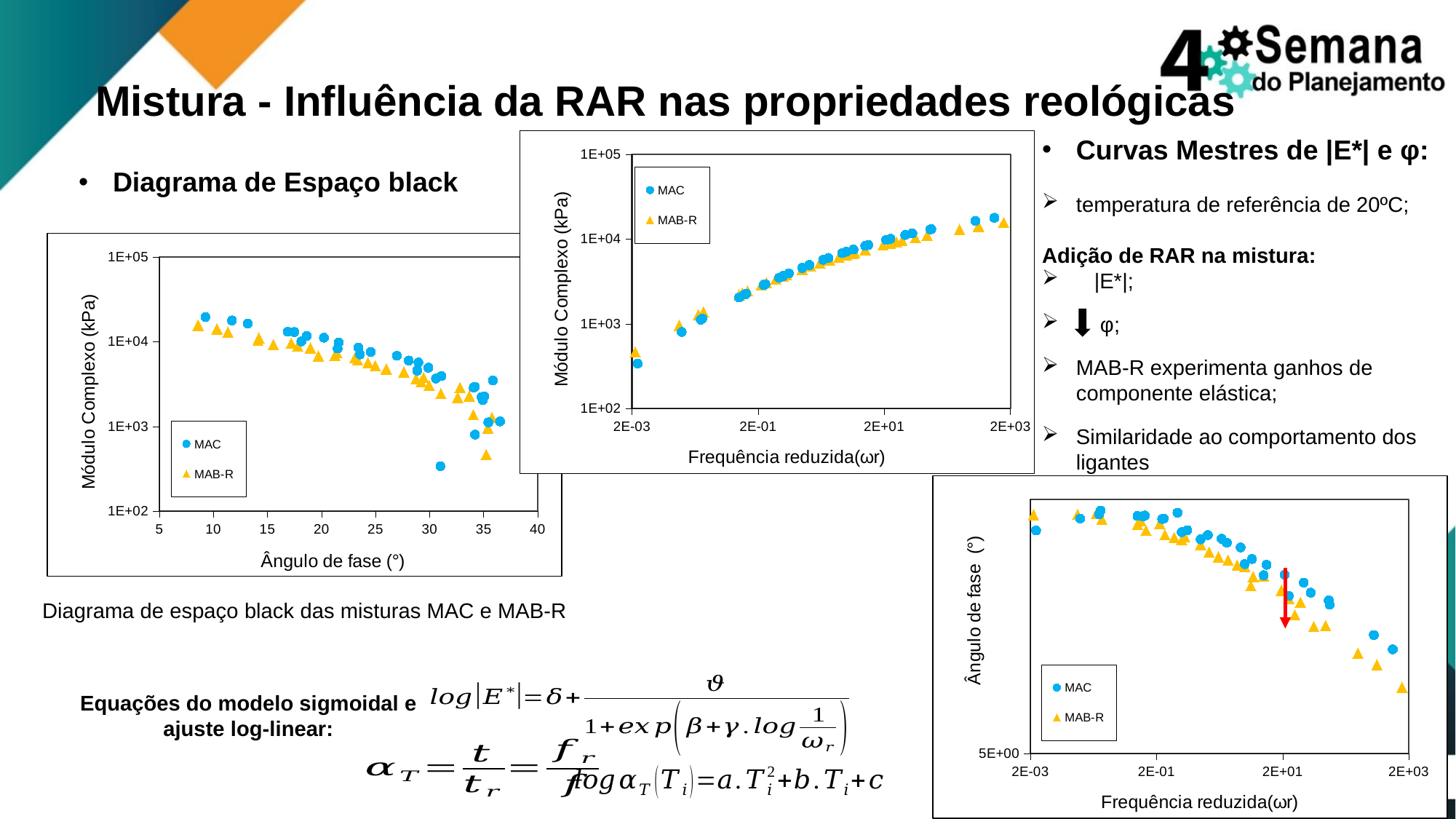
In the top middle chart (Módulo Complexo vs Frequência reduzida), do the values rise or fall as the reduced frequency increases? rise What kind of chart is the 'Diagrama de espaço black' chart on the left of the slide? scatter chart How many series does the legend of the left chart (Diagrama de espaço black) list? 2 In the top middle chart, is the MAC complex modulus at a reduced frequency of 2E-03 greater or less than 1E+03 kPa? less In the left chart (Diagrama de espaço black), is the MAC complex modulus at a phase angle of about 10° greater or less than 1E+04 kPa? greater In the bottom right chart (Ângulo de fase vs Frequência reduzida), which series shows the lower phase angle at high reduced frequencies, MAC or MAB-R? MAB-R What is the x-axis title of the left chart (Diagrama de espaço black)? Ângulo de fase (°) In the left chart (Diagrama de espaço black), which series generally shows the higher complex modulus at a given phase angle, MAC or MAB-R? MAC In the top middle chart, is the MAC complex modulus at a reduced frequency of 2E+03 greater or less than 1E+04 kPa? greater What are the two series named in the legend of the top middle chart (Módulo Complexo vs Frequência reduzida)? MAC and MAB-R In the bottom right chart (Ângulo de fase vs Frequência reduzida), do the values rise or fall as the reduced frequency increases? fall In the left chart (Diagrama de espaço black), does the complex modulus rise or fall as the phase angle increases? fall